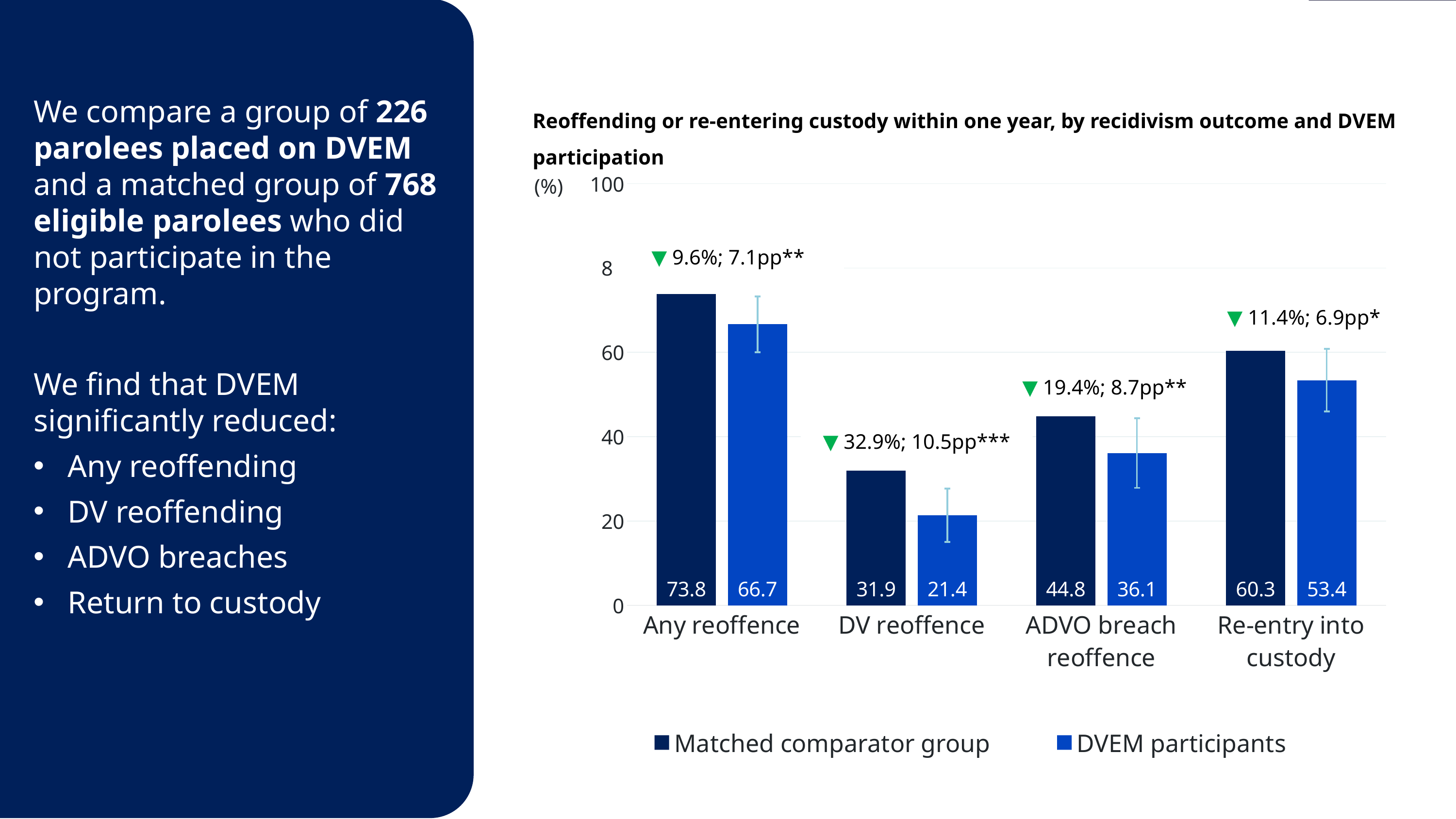
What is the difference between the Matched comparator group and DVEM participants for ADVO breach reoffence? 8.7 How many categories are shown on the x axis? 4 How many series does the legend list? 2 What is the value for DVEM participants for Re-entry into custody? 53.4 Is the value for DVEM participants for Any reoffence greater or less than 60? greater What kind of chart is shown on the slide? Bar chart Which is larger for Re-entry into custody: the Matched comparator group or DVEM participants? Matched comparator group What is the value for the Matched comparator group for Any reoffence? 73.8 Which category has the lowest value for DVEM participants? DV reoffence What is the value for DVEM participants for DV reoffence? 21.4 Which category has the highest value for the Matched comparator group? Any reoffence What are the two series listed in the legend? Matched comparator group and DVEM participants